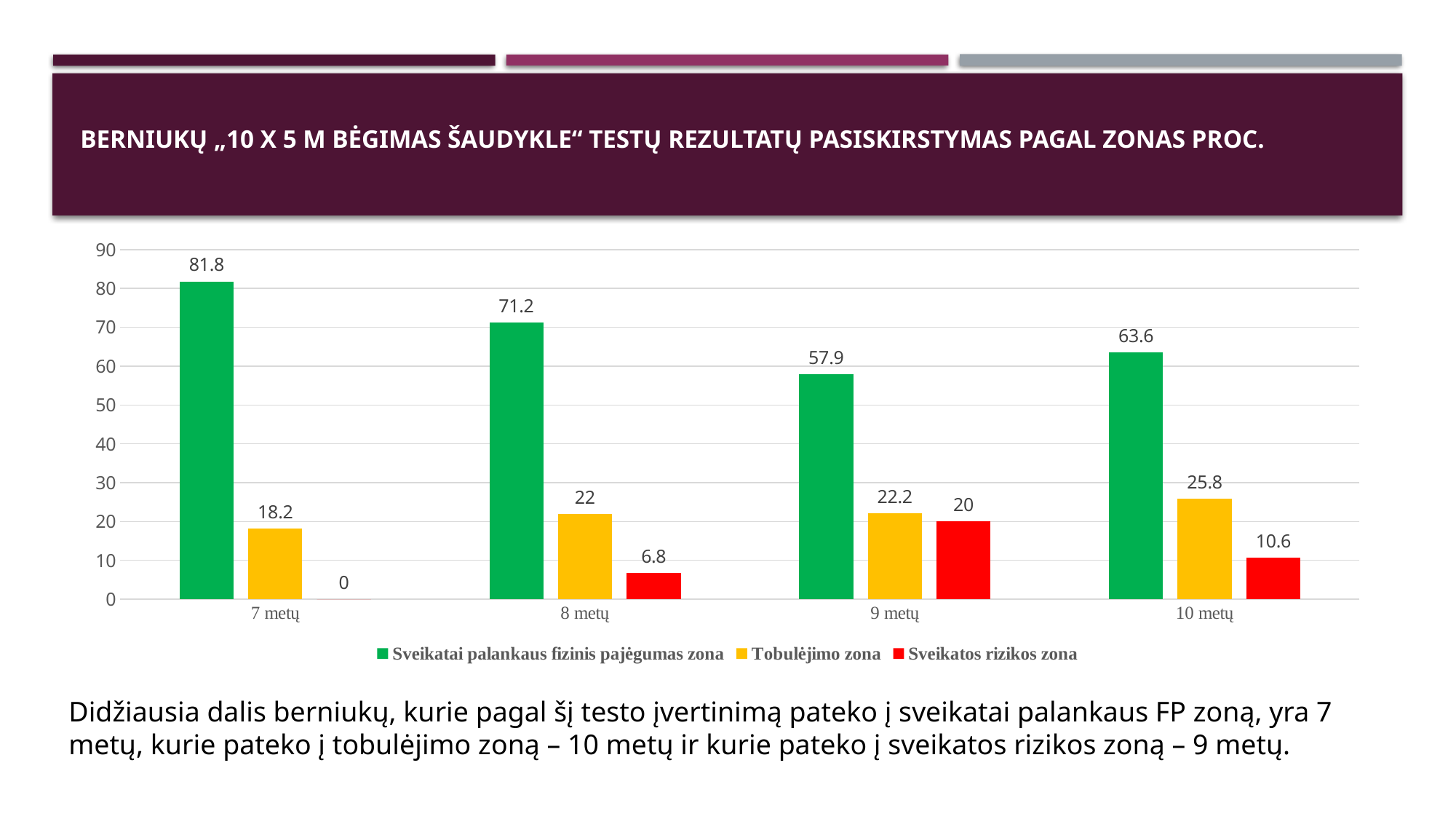
What colour are the bars for 'Sveikatos rizikos zona'? Red Which age group has the highest value for 'Sveikatai palankaus fizinis pajėgumas zona'? 7 metų Which age group has the lowest value for 'Sveikatos rizikos zona'? 7 metų Which is larger: 'Tobulėjimo zona' at 9 metų or 'Sveikatos rizikos zona' at 9 metų? Tobulėjimo zona at 9 metų Is the value for 'Sveikatai palankaus fizinis pajėgumas zona' at 10 metų greater or less than 60? greater What is the value for 'Sveikatos rizikos zona' at 8 metų? 6.8 How many series does the legend list? 3 How many age groups are shown on the x axis? 4 What is the value for 'Tobulėjimo zona' at 10 metų? 25.8 What is the value for 'Sveikatai palankaus fizinis pajėgumas zona' at 7 metų? 81.8 What kind of chart is shown on the slide? Bar chart What is the difference between the 'Sveikatai palankaus fizinis pajėgumas zona' values for 7 metų and 9 metų? 23.9